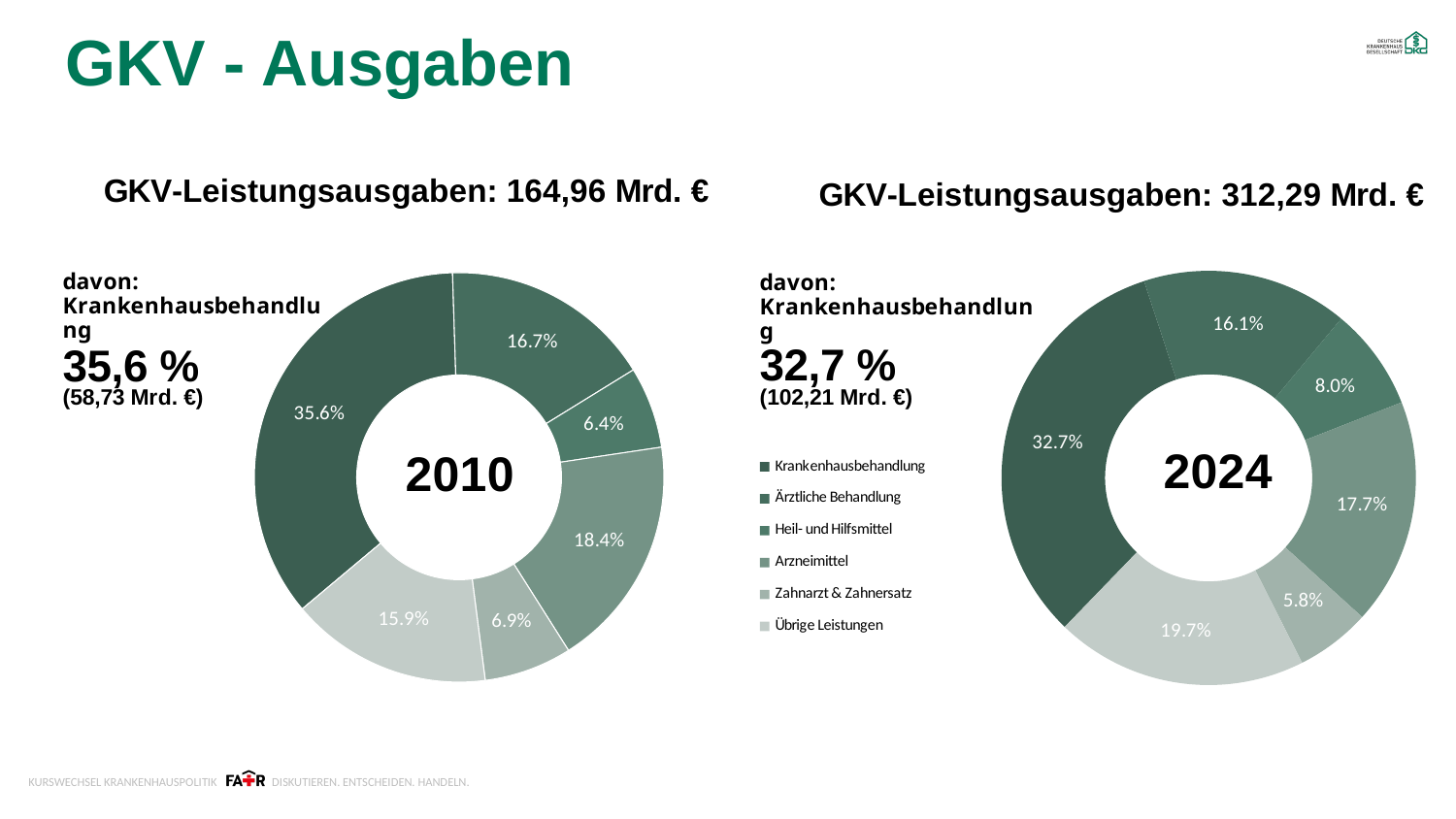
In the 2024 chart, what is the smallest slice value shown? 5.8% What total GKV-Leistungsausgaben is stated above the 2024 chart? 312,29 Mrd. € What amount in Mrd. € is given for Krankenhausbehandlung next to the 2010 chart? 58,73 Mrd. € Is the Krankenhausbehandlung share larger in the 2010 chart or the 2024 chart? 2010 In the 2010 chart, which category has the largest share? Krankenhausbehandlung How many slices does the 2024 chart have? 6 In the 2024 chart, what share of GKV-Leistungsausgaben is Krankenhausbehandlung? 32.7% In the 2010 chart, what is the smallest slice value shown? 6.4% How many categories does the legend list? 6 In the 2010 chart, what share of GKV-Leistungsausgaben is Krankenhausbehandlung? 35.6% What kind of chart is used for the 2010 data? Donut (pie) chart What is the difference between the Krankenhausbehandlung share in 2010 (35.6%) and in 2024 (32.7%)? 2.9 percentage points